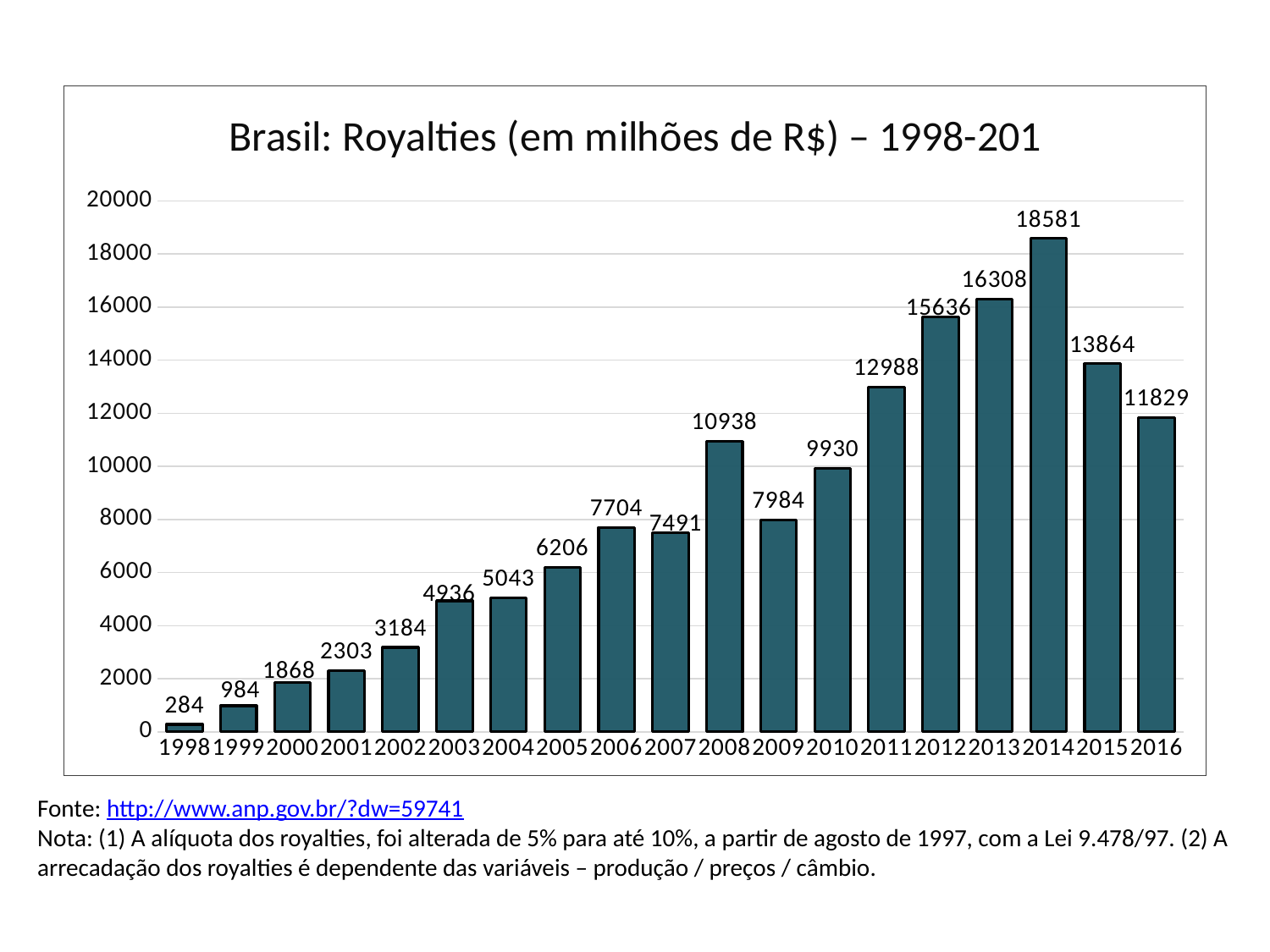
What is the difference between the royalties values for 2014 and 2015? 4717 What kind of chart is shown on the slide? bar chart What is the royalties value for 2008? 10938 Which year has the highest royalties value? 2014 What is the royalties value for 2016? 11829 Do the royalties values generally rise or fall from 1998 to 2014? rise How many years are shown on the x axis? 19 What is the difference between the royalties values for 2013 and 2012? 672 Is the value for 2010 greater or less than 10000? less What is the royalties value for 1998? 284 Which year has the lowest royalties value? 1998 Which year has a larger royalties value, 2006 or 2007? 2006